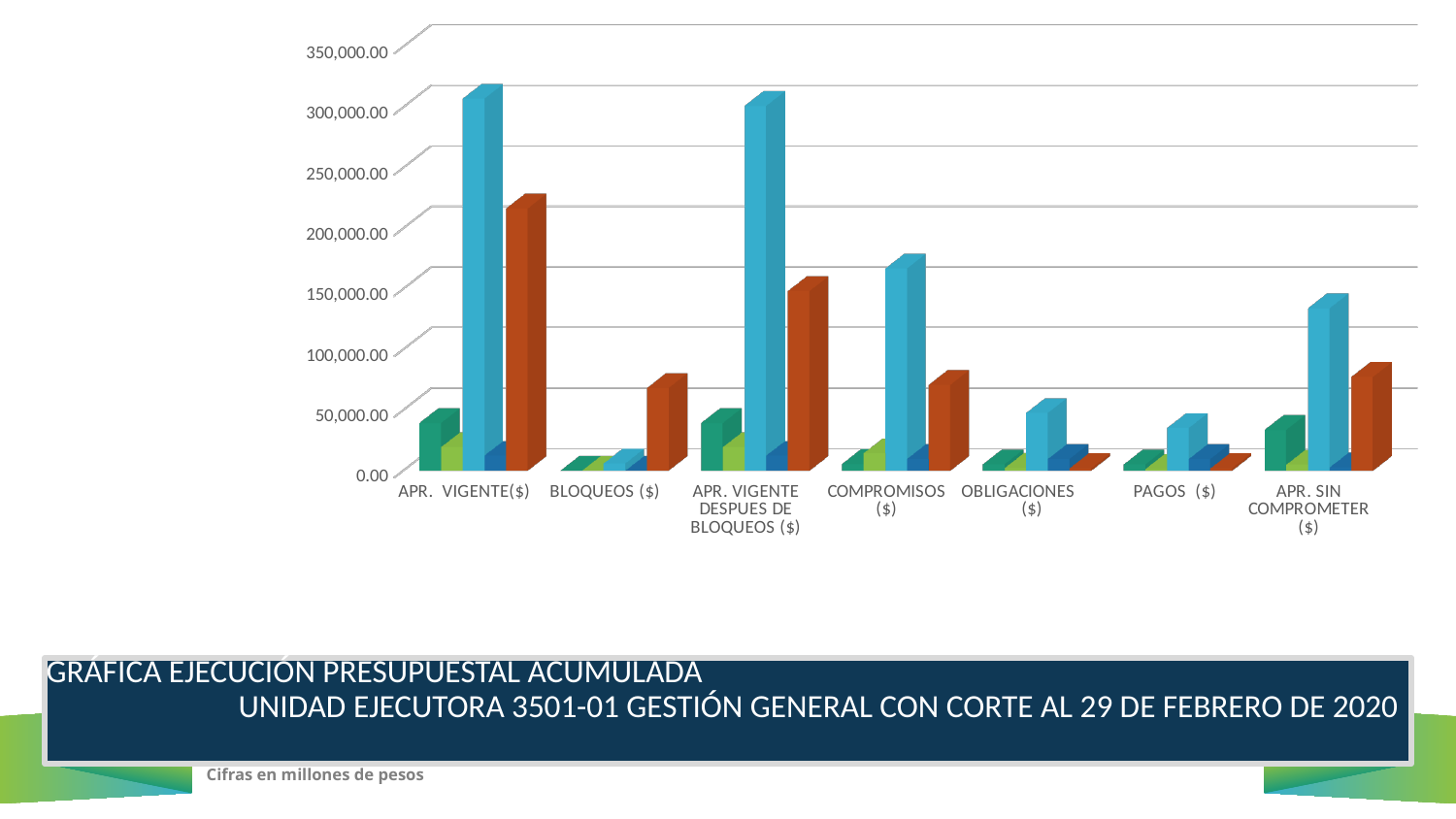
Is the value of the light blue bar for BLOQUEOS ($) greater or less than 50,000.00? less According to the note below the chart, in what units are the figures expressed? Cifras en millones de pesos Which has the larger light blue bar, APR. VIGENTE($) or COMPROMISOS ($)? APR. VIGENTE($) Which category has the lowest light blue bar? BLOQUEOS ($) Is the value of the orange bar for BLOQUEOS ($) greater or less than 50,000.00? greater Is the value of the tallest (light blue) bar for APR. VIGENTE($) greater or less than 250,000.00? greater What is the highest value shown on the vertical axis of the chart? 350,000.00 What kind of chart is shown on the slide? bar chart How many categories are shown along the x axis of the chart? 7